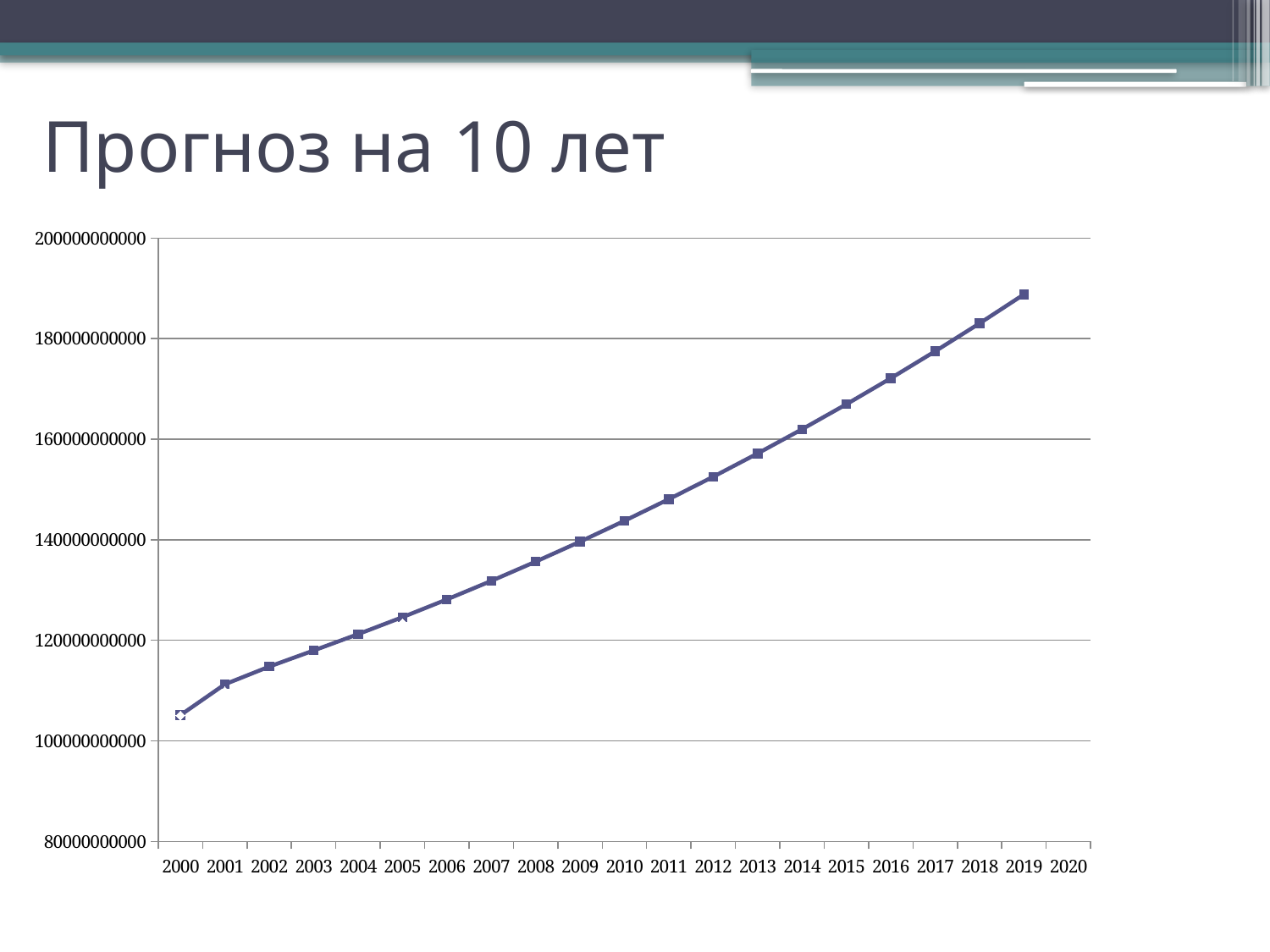
What is the lowest value shown on the vertical axis? 80000000000 Which is larger, the value for 2015 or the value for 2005? 2015 What kind of chart is shown on the slide? line chart Which year has the lowest value on the chart? 2000 Is the value for 2019 greater or less than 200000000000? less What is the title of the chart? Прогноз на 10 лет Is the value for 2013 greater or less than 160000000000? less Is the value for 2002 greater or less than 120000000000? less Which year has the highest value on the chart? 2019 Do the values rise or fall from 2000 to 2019? rise